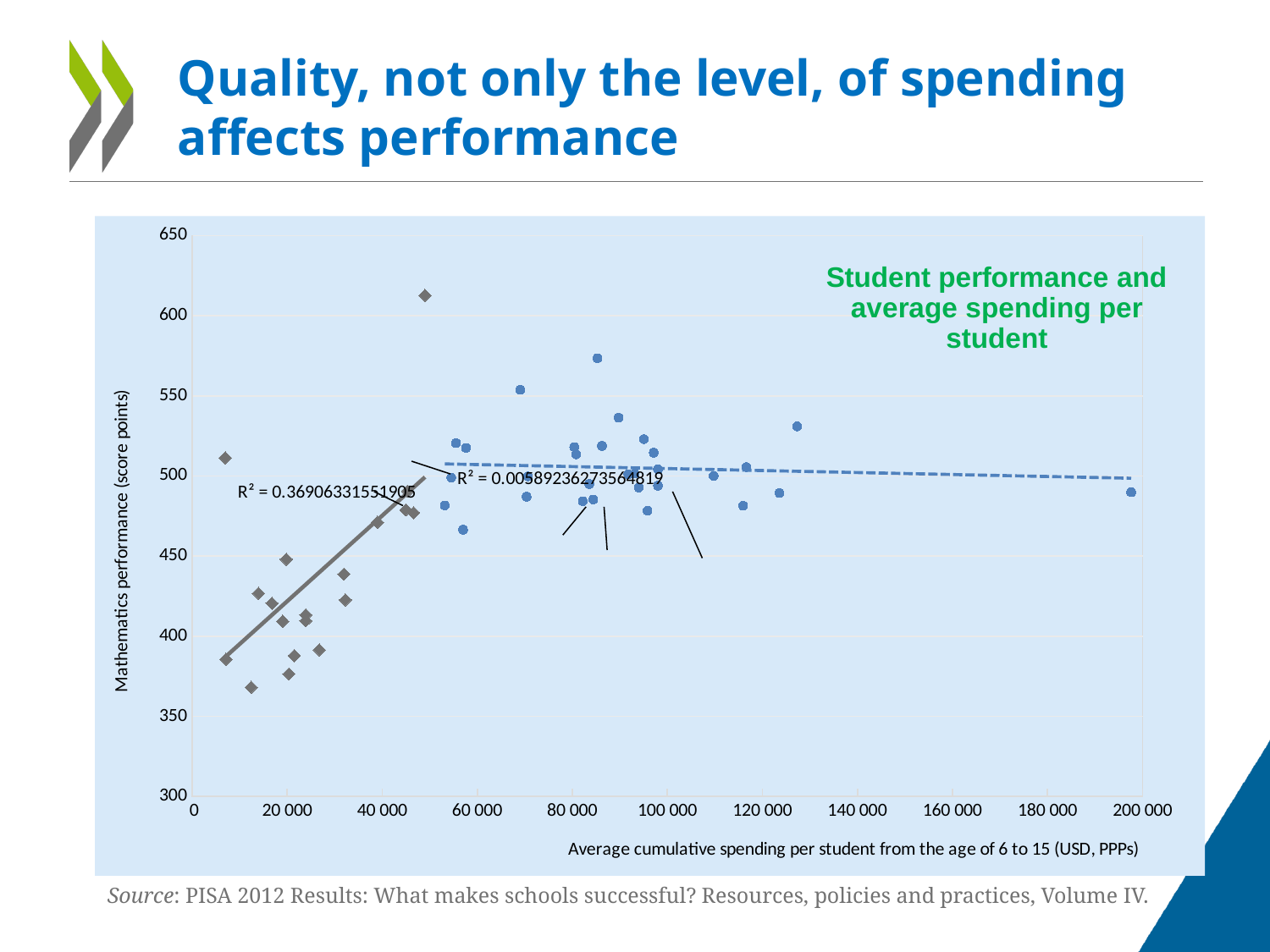
Which trendline has the larger R² value, the grey solid one or the blue dashed one? The grey solid one Is the mathematics performance of the rightmost blue point (near 200 000 USD) greater or less than 500? less Is the mathematics performance of the highest blue circle point greater or less than 550? greater Does the grey solid trendline rise or fall as spending increases? Rises Is the mathematics performance of the highest grey diamond point greater or less than 600? greater What is the highest value shown on the vertical axis of the chart? 650 What R² value is printed next to the blue dashed trendline? R² = 0.00589236273564819 What R² value is printed next to the grey solid trendline? R² = 0.36906331551905 What is the label of the vertical axis of the chart? Mathematics performance (score points) What kind of chart is shown on the slide? Scatter chart What is the title of the chart? Student performance and average spending per student